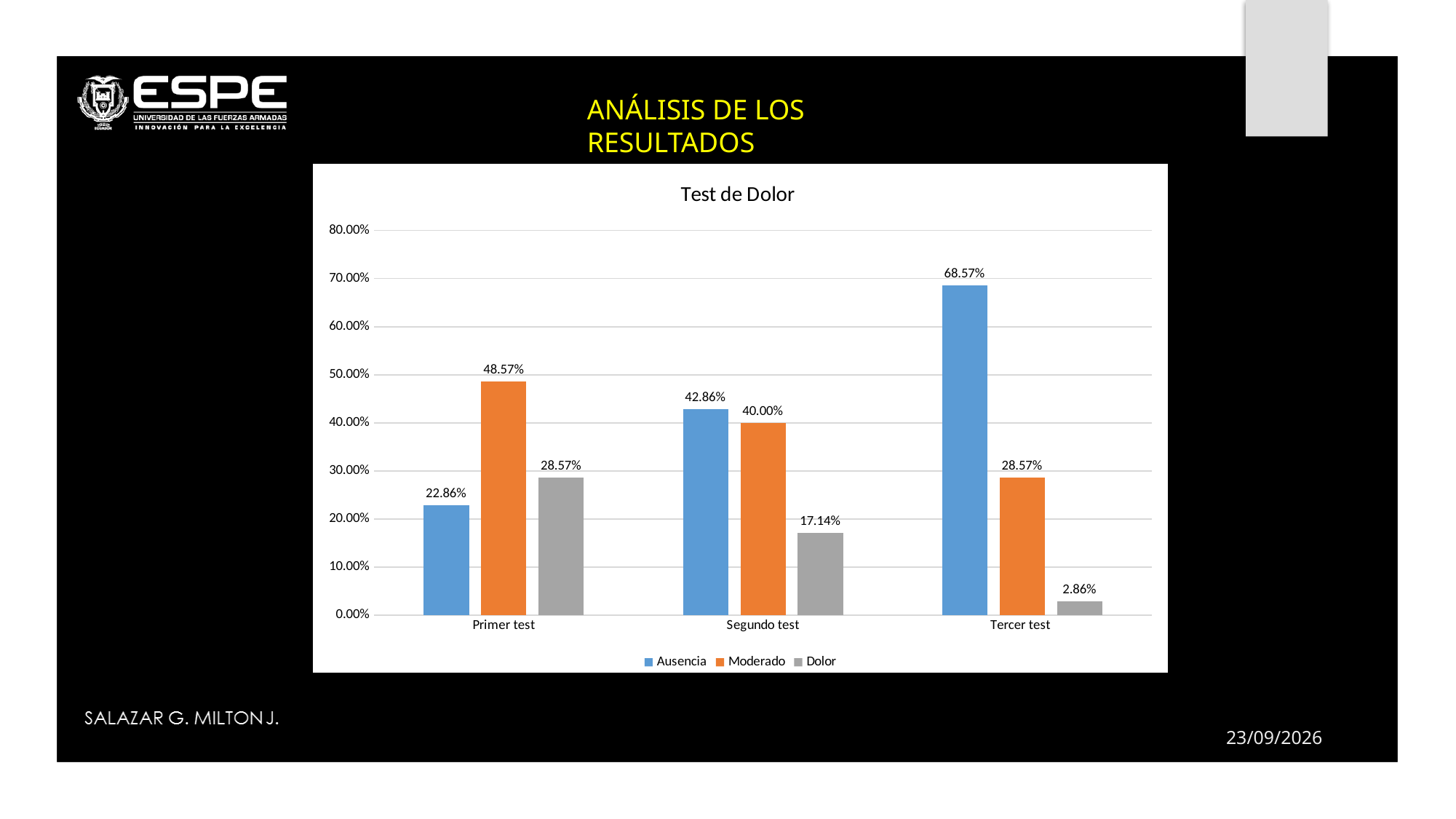
Which is larger in Segundo test, Ausencia or Moderado? Ausencia Does the Dolor series rise or fall from Primer test to Tercer test? Fall What is the value for Moderado in Segundo test? 40.00% Which test has the highest value for Ausencia? Tercer test What is the value for Dolor in Tercer test? 2.86% Is the value for Moderado in Primer test greater or less than 40.00%? greater How many series does the legend list? 3 What kind of chart is shown? Bar chart What is the difference between the Ausencia values for Tercer test and Primer test? 45.71% How many test categories are shown on the x axis? 3 Which test has the lowest value for Dolor? Tercer test What is the value for Ausencia in Primer test? 22.86%